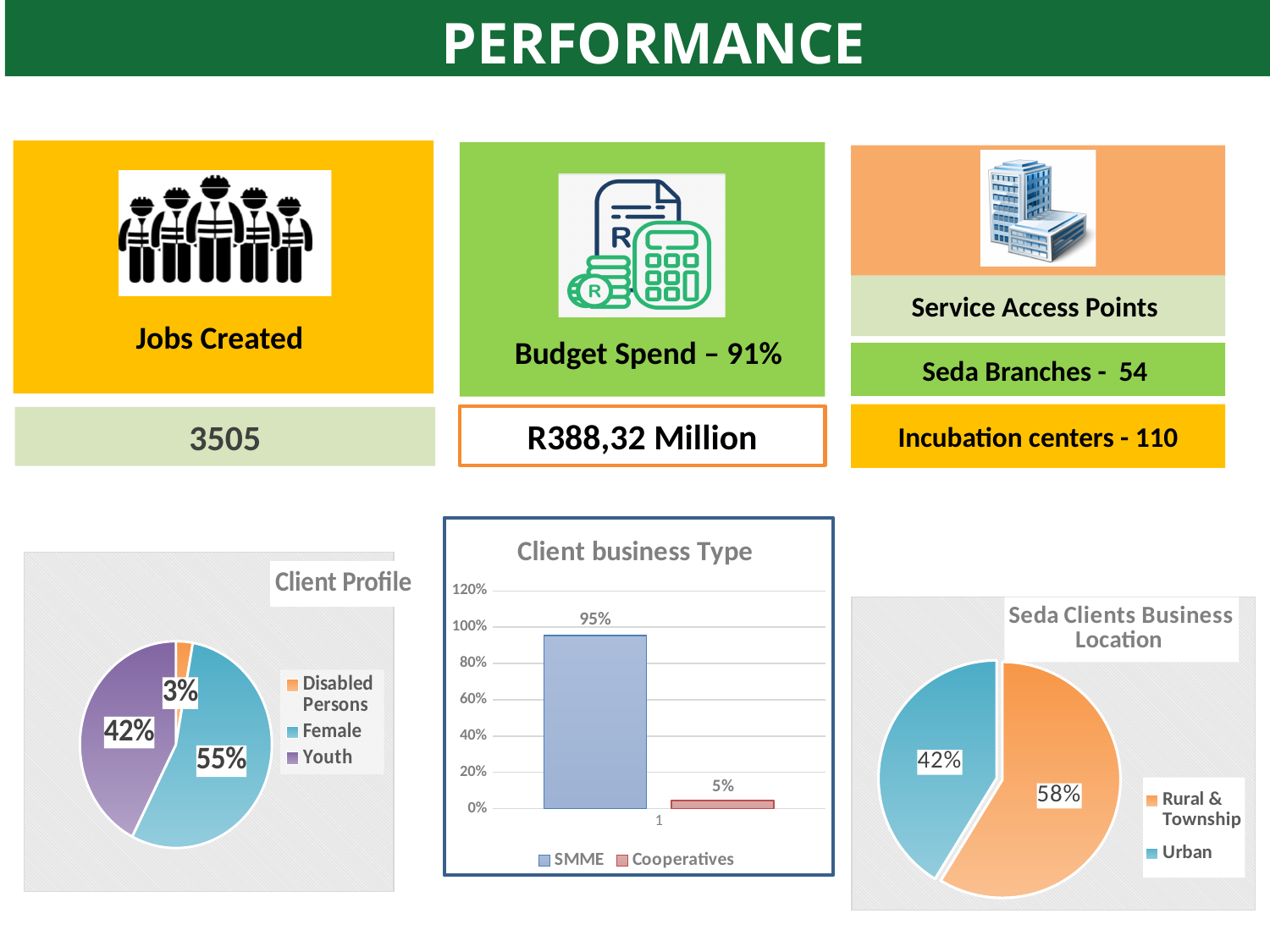
In the Seda Clients Business Location pie chart, which is larger, Rural & Township or Urban? Rural & Township What kind of chart is the Client business Type chart? bar chart In the Client Profile pie chart, what share is Youth? 42% In the Seda Clients Business Location pie chart, what share is Rural & Township? 58% In the Seda Clients Business Location pie chart, what is the difference between Rural & Township and Urban? 16% How many series does the legend of the Client business Type chart list? 2 In the Client Profile pie chart, what share is Female? 55% In the Client Profile pie chart, how many categories does the legend list? 3 In the Client business Type chart, what is the value for Cooperatives? 5% In the Client business Type chart, what is the difference between SMME and Cooperatives? 90% In the Client business Type chart, what is the value for SMME? 95% In the Client Profile pie chart, which category has the smallest share? Disabled Persons